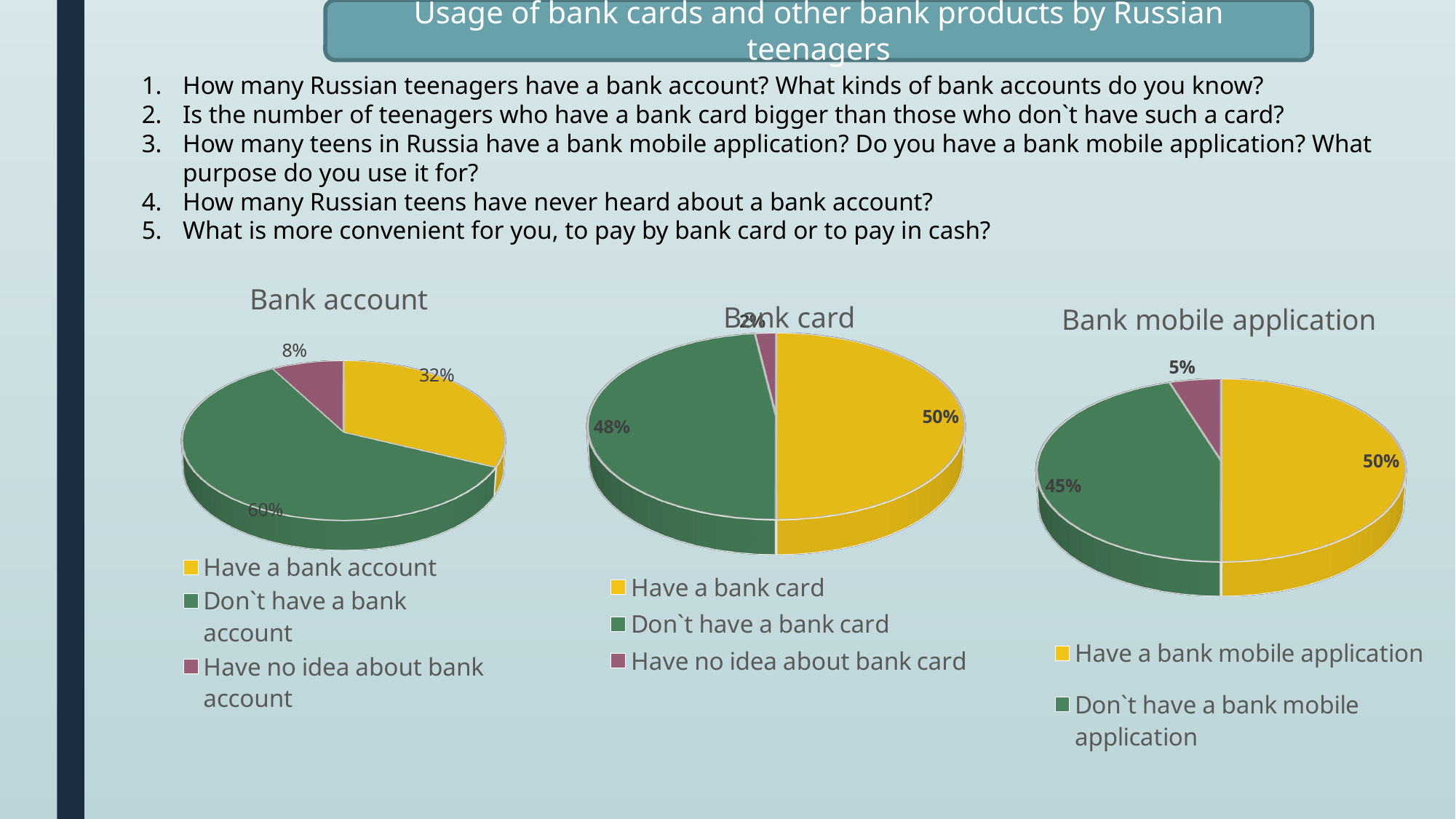
In the 'Bank mobile application' chart, what percentage don`t have a bank mobile application? 45% In the 'Bank card' chart, which is larger: 'Have a bank card' or 'Don`t have a bank card'? Have a bank card In the 'Bank card' chart, what percentage have a bank card? 50% In the 'Bank card' chart, what percentage have no idea about a bank card? 2% What type of chart is the 'Bank card' chart? Pie chart In the 'Bank account' chart, what share of the pie is 'Don`t have a bank account'? 60% In the 'Bank mobile application' chart, what is the difference between 'Have a bank mobile application' and 'Don`t have a bank mobile application'? 5% In the 'Bank account' chart, which category has the largest slice? Don`t have a bank account In the 'Bank card' chart, which category has the smallest slice? Have no idea about bank card In the 'Bank account' chart, what percentage of Russian teenagers have a bank account? 32% In the 'Bank account' chart, what is the difference between 'Don`t have a bank account' and 'Have a bank account'? 28% In the 'Bank account' chart, what percentage have no idea about a bank account? 8%